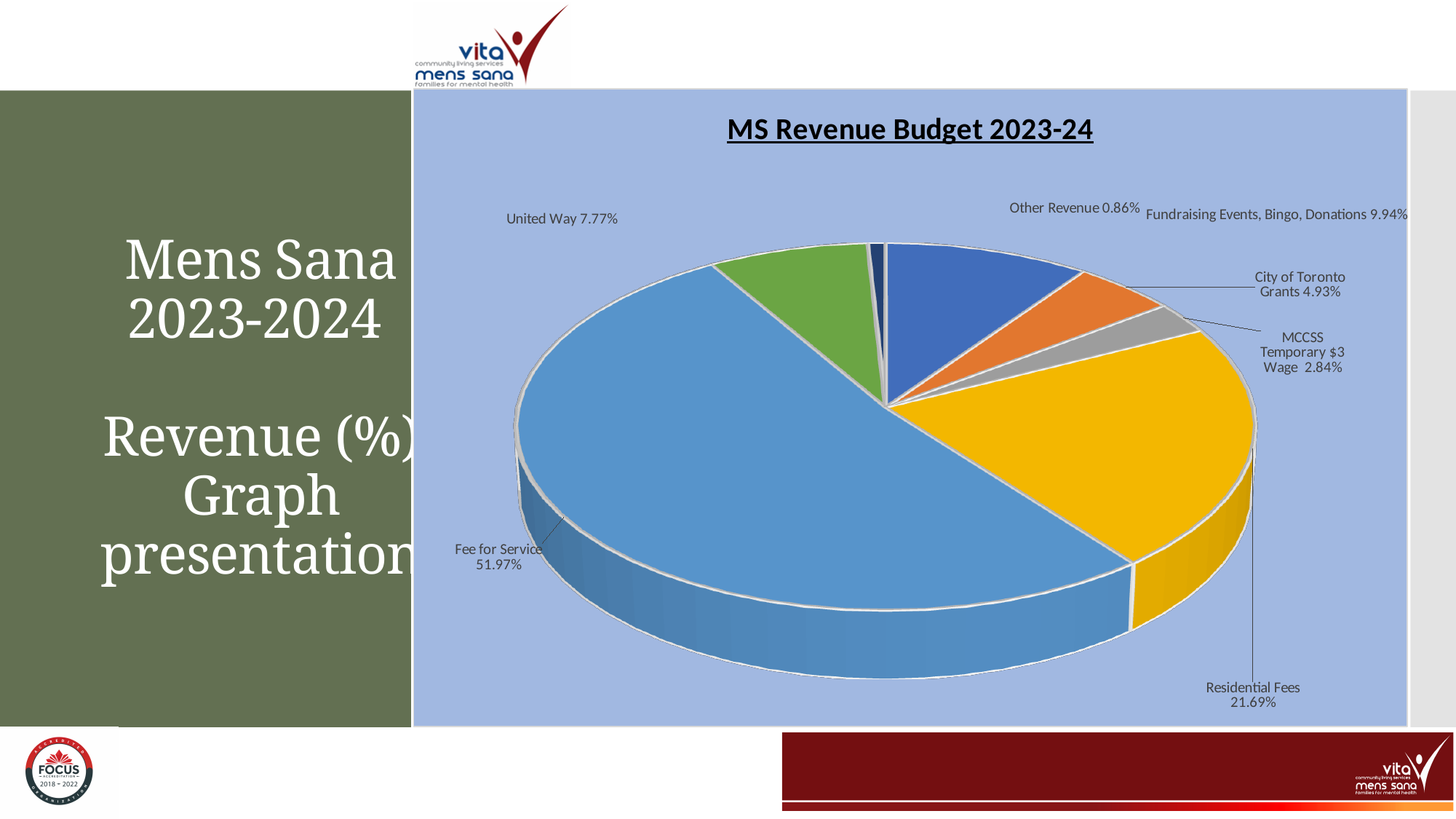
What percentage of the revenue budget is Residential Fees? 21.69% Which revenue source has the largest share of the pie? Fee for Service What percentage is shown for United Way? 7.77% What percentage is shown for Fundraising Events, Bingo, Donations? 9.94% What is the title of the chart? MS Revenue Budget 2023-24 What percentage is shown for City of Toronto Grants? 4.93% Which revenue source has the smallest share of the pie? Other Revenue What is the difference in percentage points between Fee for Service and Residential Fees? 30.28 What percentage is shown for MCCSS Temporary $3 Wage? 2.84% What percentage of the revenue budget is Fee for Service? 51.97% How many slices does the pie chart have? 7 What kind of chart is shown on the slide? pie chart